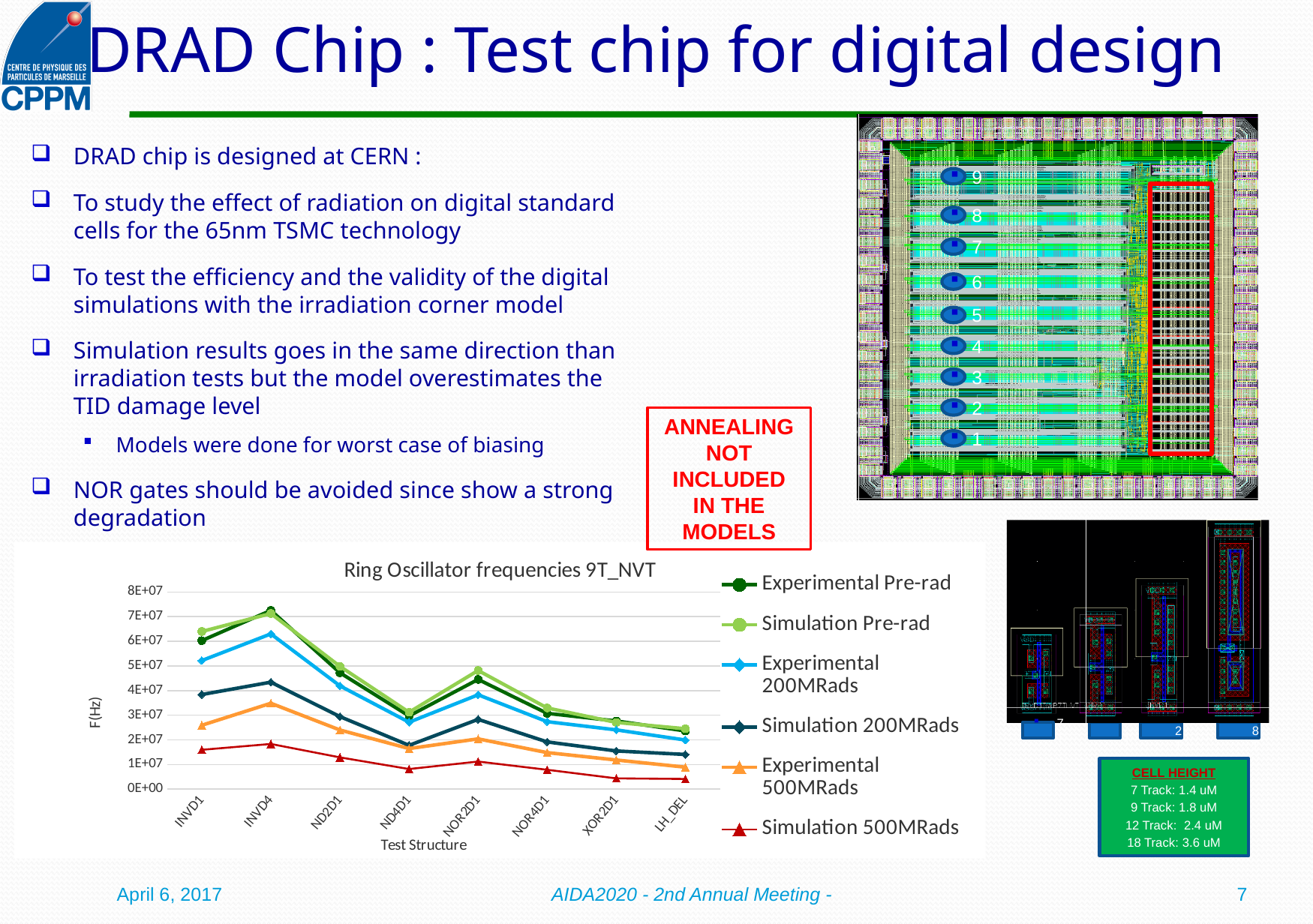
What kind of chart is 'Ring Oscillator frequencies 9T_NVT'? line chart In the 'Ring Oscillator frequencies 9T_NVT' chart, is the Experimental 500MRads value for INVD4 greater or less than 3E+07? greater In the 'Ring Oscillator frequencies 9T_NVT' chart, is the Simulation 500MRads value for LH_DEL greater or less than 1E+07? less In the 'Ring Oscillator frequencies 9T_NVT' chart, do the Experimental Pre-rad values rise or fall from NOR2D1 to LH_DEL? fall In the 'Ring Oscillator frequencies 9T_NVT' chart, which test structure has the lowest Experimental 200MRads frequency? LH_DEL What is the y-axis title of the 'Ring Oscillator frequencies 9T_NVT' chart? F(Hz) In the 'Ring Oscillator frequencies 9T_NVT' chart, which test structure has the highest Experimental Pre-rad frequency? INVD4 In the 'Ring Oscillator frequencies 9T_NVT' chart, which is larger for Experimental Pre-rad: INVD1 or NOR2D1? INVD1 How many test structures are plotted along the x axis of the 'Ring Oscillator frequencies 9T_NVT' chart? 8 In the 'Ring Oscillator frequencies 9T_NVT' chart, is the Simulation 500MRads value for INVD1 greater or less than 1E+07? greater How many series does the legend of the 'Ring Oscillator frequencies 9T_NVT' chart list? 6